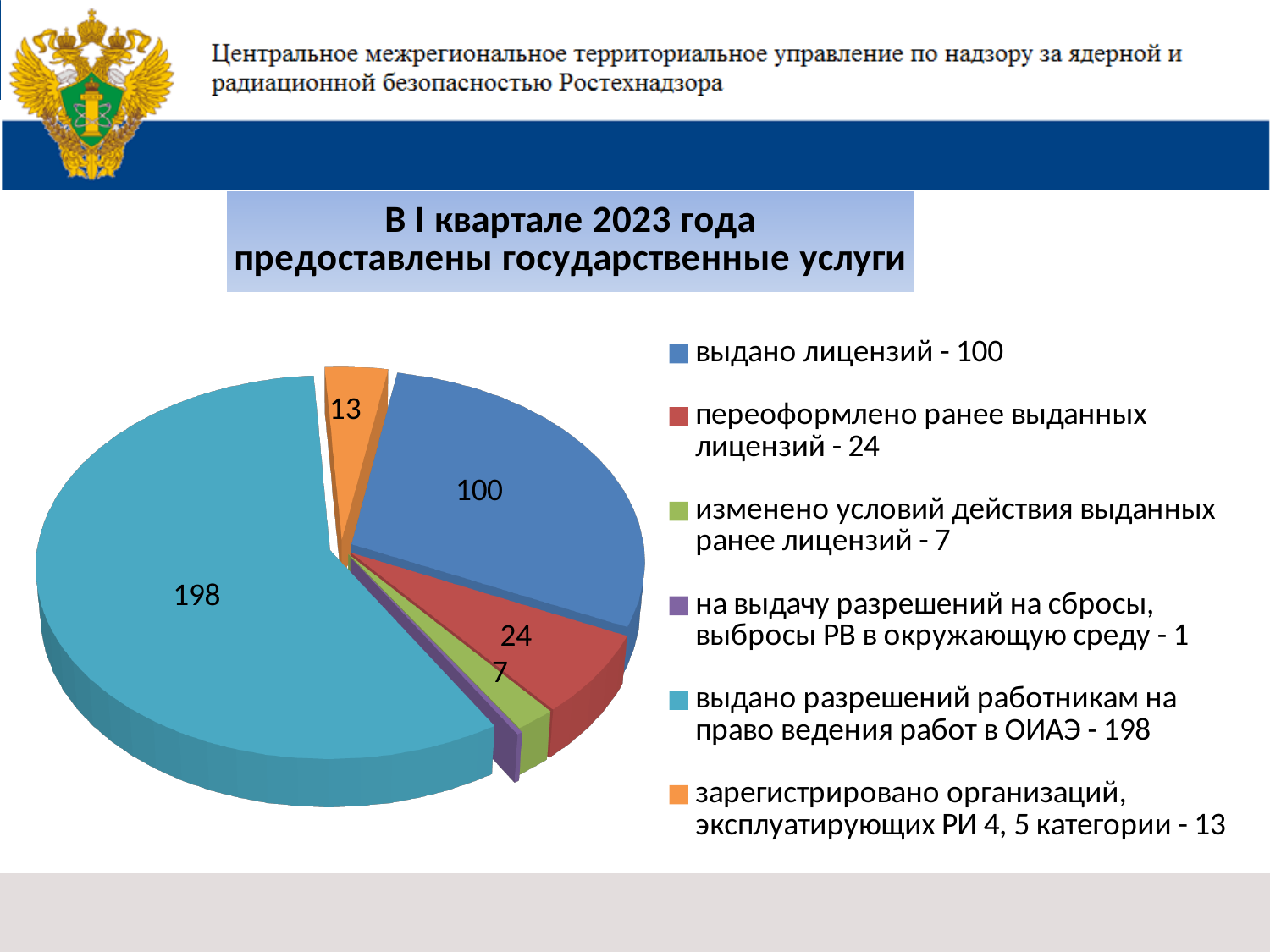
Which category has the smallest slice of the pie? на выдачу разрешений на сбросы, выбросы РВ в окружающую среду How many slices does the pie chart have? 6 How many entries does the legend list? 6 What is the value for "выдано лицензий"? 100 What is the value for "переоформлено ранее выданных лицензий"? 24 What is the value for "изменено условий действия выданных ранее лицензий"? 7 What colour is the slice for "выдано лицензий - 100"? Blue Which is larger: the value for "переоформлено ранее выданных лицензий" or the value for "зарегистрировано организаций, эксплуатирующих РИ 4, 5 категории"? переоформлено ранее выданных лицензий What is the difference between the value for "выдано разрешений работникам на право ведения работ в ОИАЭ" and the value for "выдано лицензий"? 98 Which category has the largest slice of the pie? выдано разрешений работникам на право ведения работ в ОИАЭ What kind of chart is shown on the slide? Pie chart What is the value for "зарегистрировано организаций, эксплуатирующих РИ 4, 5 категории"? 13